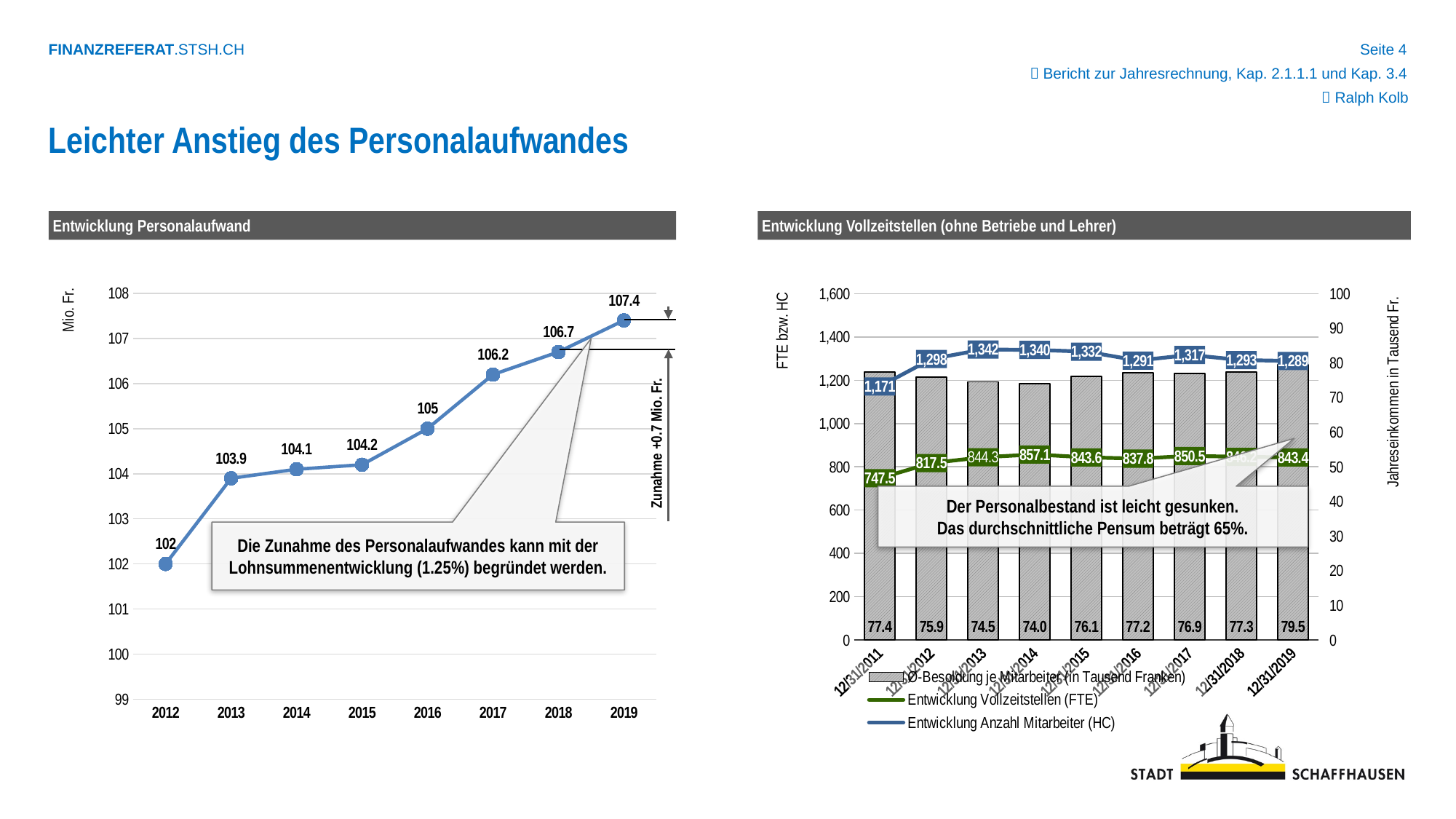
In the 'Entwicklung Vollzeitstellen (ohne Betriebe und Lehrer)' chart, which is larger: the HC value for 12/31/2011 or for 12/31/2012? 12/31/2012 In the 'Entwicklung Personalaufwand' chart, what is the difference between the 2019 and 2018 values? 0.7 In the 'Entwicklung Vollzeitstellen (ohne Betriebe und Lehrer)' chart, which date has the lowest Entwicklung Vollzeitstellen (FTE) value? 12/31/2011 What kind of chart is 'Entwicklung Personalaufwand'? line chart In the 'Entwicklung Personalaufwand' chart, which year has the lowest value? 2012 In the 'Entwicklung Personalaufwand' chart, what is the value for 2012? 102 In the 'Entwicklung Vollzeitstellen (ohne Betriebe und Lehrer)' chart, what is the Ø-Besoldung je Mitarbeiter value for 12/31/2019? 79.5 How many dates are shown on the x axis of the 'Entwicklung Vollzeitstellen (ohne Betriebe und Lehrer)' chart? 9 In the 'Entwicklung Personalaufwand' chart, what is the value for 2019? 107.4 In the 'Entwicklung Personalaufwand' chart, do the values rise or fall from 2012 to 2019? rise In the 'Entwicklung Vollzeitstellen (ohne Betriebe und Lehrer)' chart, what is the Entwicklung Anzahl Mitarbeiter (HC) value for 12/31/2013? 1,342 How many series does the legend of the 'Entwicklung Vollzeitstellen (ohne Betriebe und Lehrer)' chart list? 3